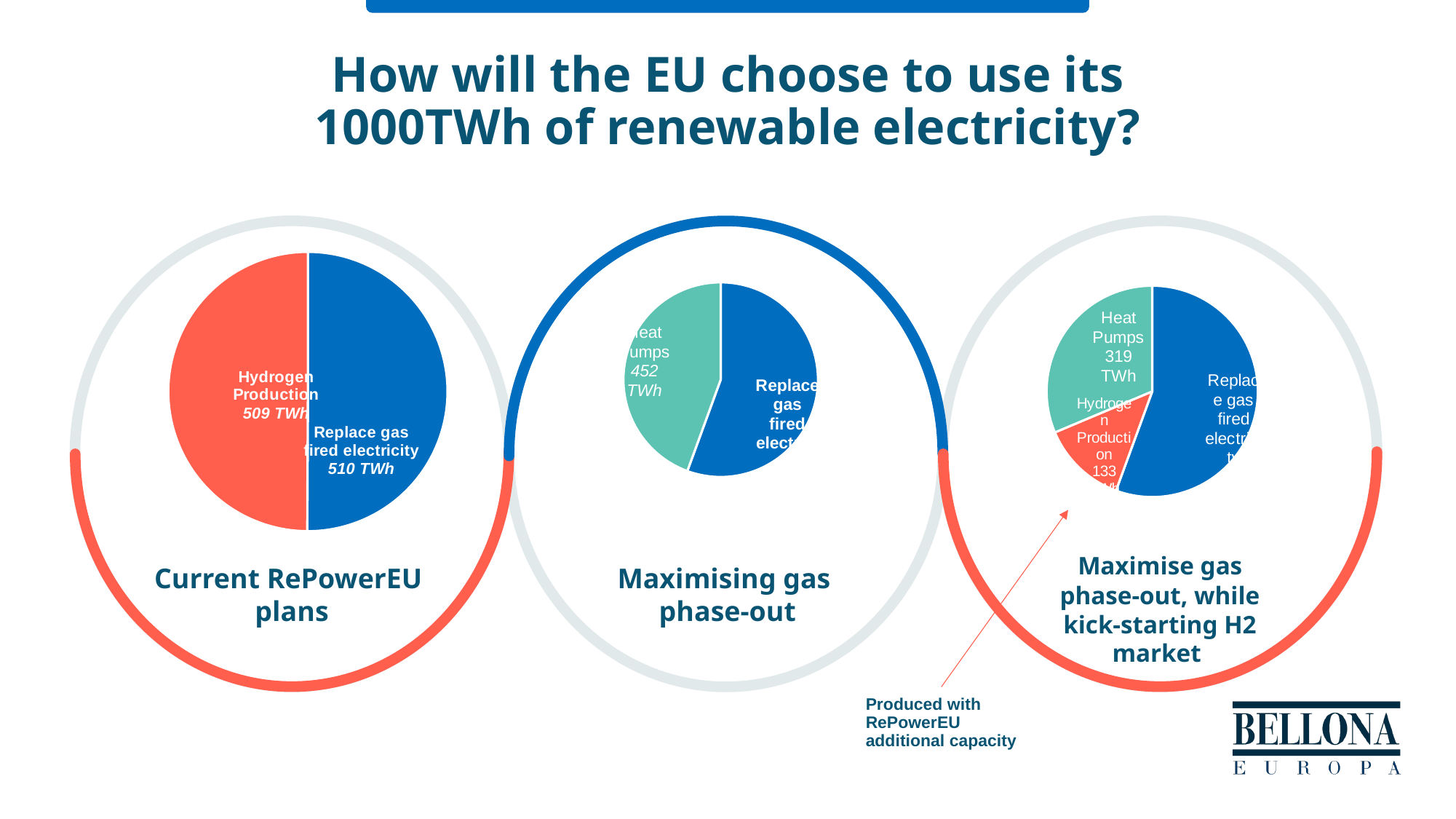
In the "Maximise gas phase-out, while kick-starting H2 market" chart, which category has the largest slice? Replace gas fired electricity How many slices does the "Current RePowerEU plans" pie chart have? 2 In the "Maximise gas phase-out, while kick-starting H2 market" chart, what is the value for Heat Pumps? 319 TWh In the "Current RePowerEU plans" chart, what is the difference between Replace gas fired electricity and Hydrogen Production? 1 TWh In the "Maximising gas phase-out" chart, what is the value for Heat Pumps? 452 TWh In the "Current RePowerEU plans" chart, what colour is the Hydrogen Production slice? Red In the "Maximising gas phase-out" chart, which slice is larger: Heat Pumps or Replace gas fired electricity? Replace gas fired electricity In the "Current RePowerEU plans" chart, what is the value for Replace gas fired electricity? 510 TWh In the "Maximise gas phase-out, while kick-starting H2 market" chart, which category has the smallest slice? Hydrogen Production In the "Current RePowerEU plans" chart, what is the value for Hydrogen Production? 509 TWh How many slices does the "Maximise gas phase-out, while kick-starting H2 market" pie chart have? 3 What kind of chart is used under "Current RePowerEU plans"? Pie chart